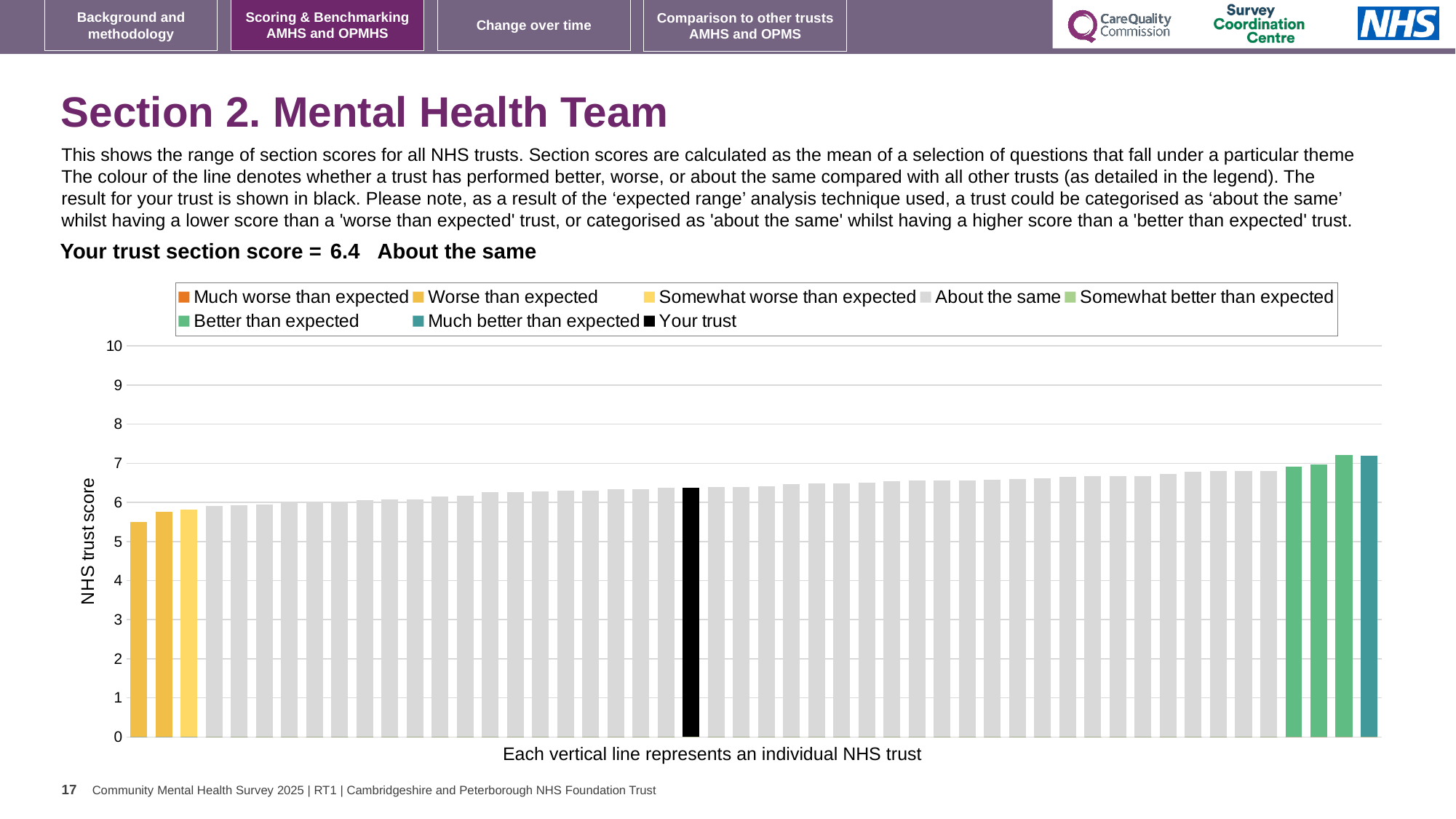
How many bars are coloured in the 'Worse than expected' yellow shade? 2 What kind of chart is shown on the slide? bar chart Which category is your trust placed in for this section? About the same According to the legend, what colour represents 'Your trust'? black How many bars are coloured black in the chart? 1 What is the section score for your trust shown on the slide? 6.4 Is the value of the leftmost bar greater or less than 6? less How many entries does the chart legend list? 8 Is the value of the black bar (your trust) greater or less than 6? greater Is the value of the tallest bar greater or less than 7? greater What is the label on the vertical axis of the chart? NHS trust score Do the bar values rise or fall from left to right along the x axis? rise